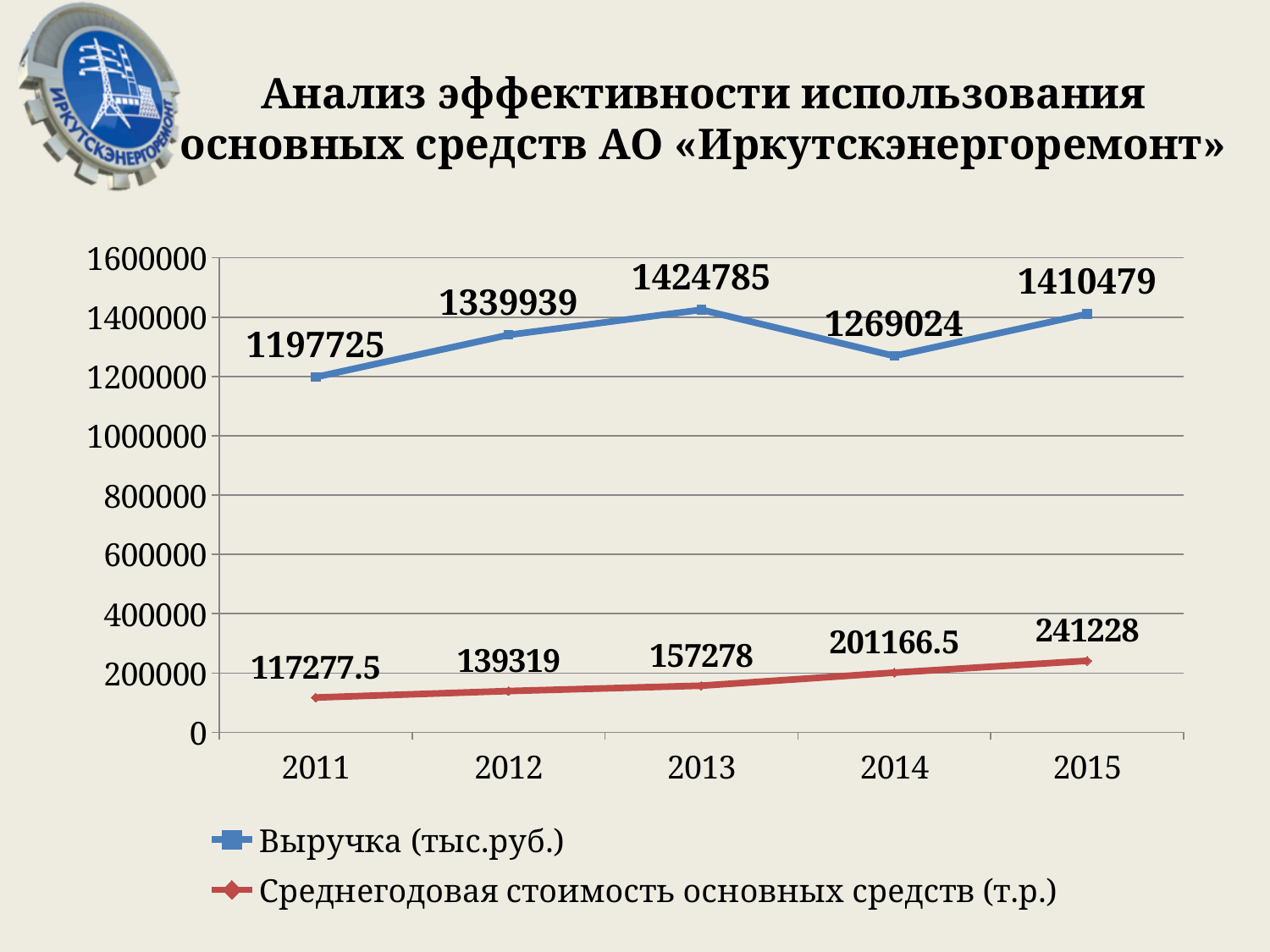
What is the value of Выручка (тыс.руб.) in 2014? 1269024 What is the value of Выручка (тыс.руб.) in 2013? 1424785 How many series does the legend list? 2 In which year is Выручка (тыс.руб.) highest? 2013 By how much did Среднегодовая стоимость основных средств (т.р.) increase from 2011 to 2015? 123950.5 What is the difference between Выручка (тыс.руб.) in 2013 and in 2011? 227060 In which year is Среднегодовая стоимость основных средств (т.р.) highest? 2015 What is the value of Среднегодовая стоимость основных средств (т.р.) in 2011? 117277.5 Which is larger: Выручка (тыс.руб.) in 2012 or in 2014? 2012 In which year is Выручка (тыс.руб.) lowest? 2011 Does Среднегодовая стоимость основных средств (т.р.) rise or fall from 2011 to 2015? rise What type of chart is shown on the slide? line chart